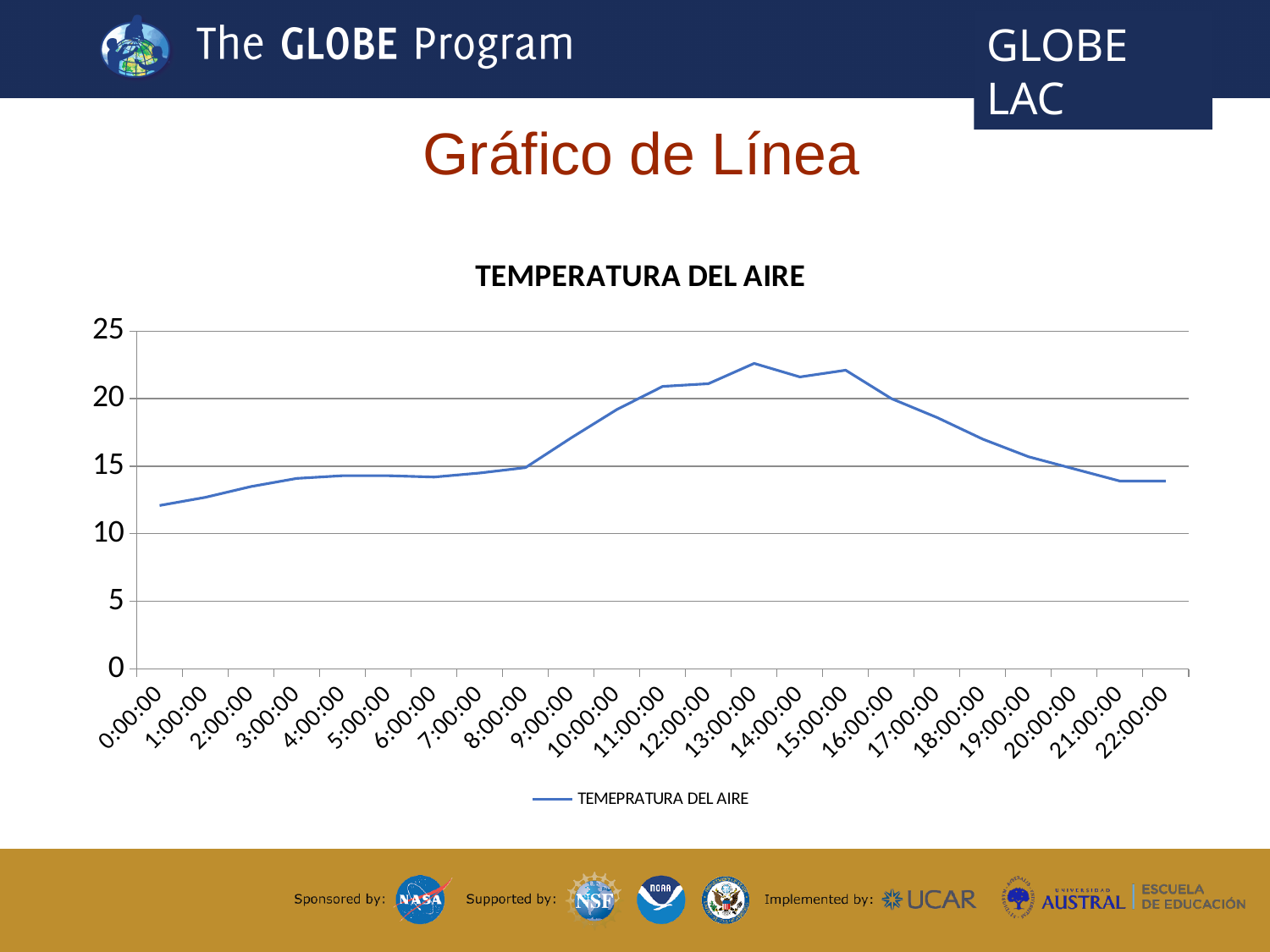
Is the value at 13:00:00 greater or less than 20? greater What is the title of the chart? TEMPERATURA DEL AIRE Do the values rise or fall between 15:00:00 and 22:00:00? fall Is the value at 0:00:00 greater or less than 15? less How many time points are plotted along the x axis? 23 At which time is the air temperature lowest? 0:00:00 What kind of chart is shown on the slide? line chart Which has the higher temperature, 3:00:00 or 17:00:00? 17:00:00 Is the value at 18:00:00 greater or less than 15? greater Do the values rise or fall between 0:00:00 and 13:00:00? rise How many series does the legend list? 1